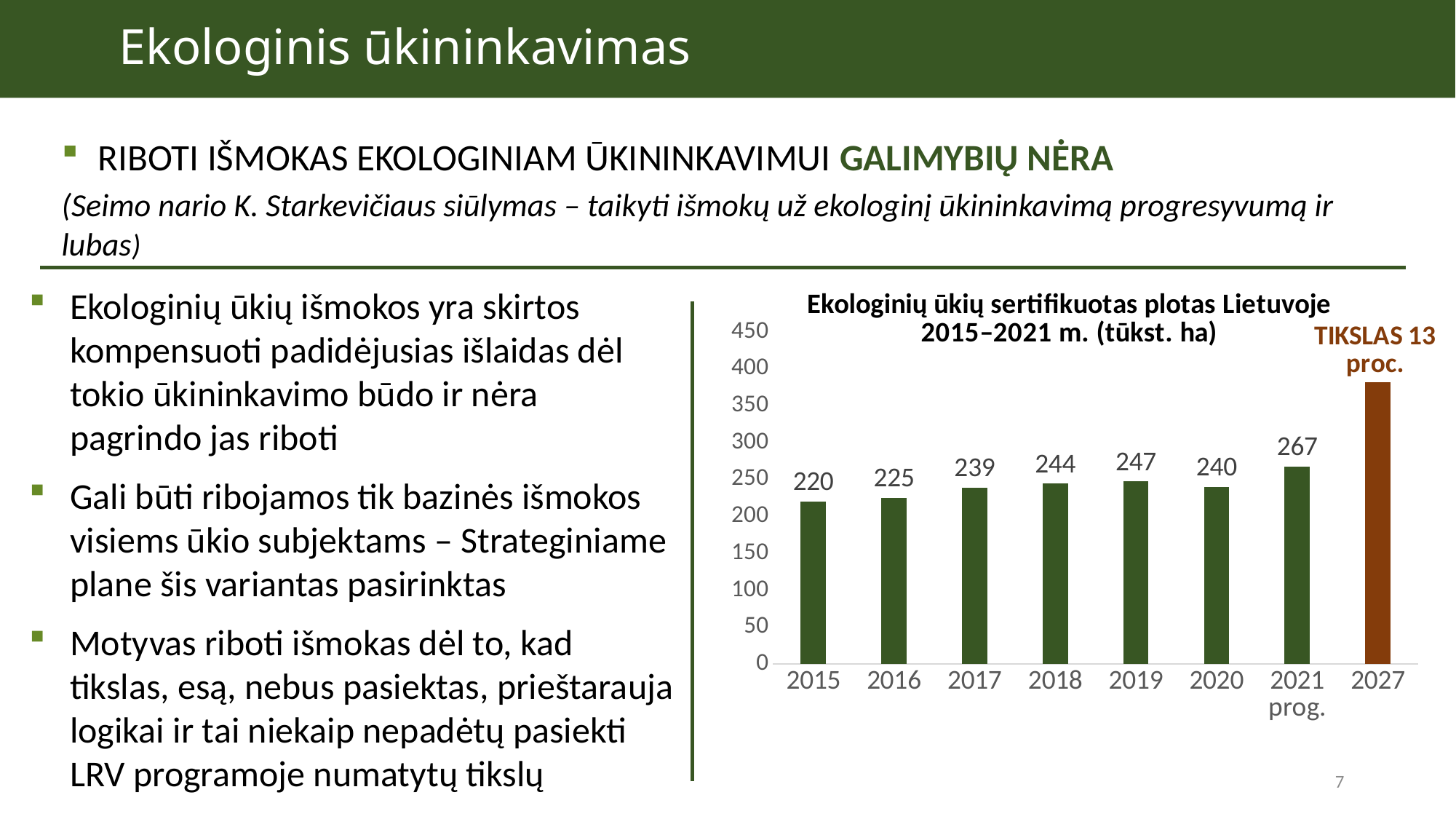
Which category has the tallest bar in the chart? 2027 How many categories are shown on the x axis of the chart? 8 Is the value for 2027 greater or less than 350? greater What is the value for 2015 in the chart? 220 What is the value for 2021 prog. in the chart? 267 Which year has the lowest value in the chart? 2015 Which is larger, the value for 2019 or the value for 2020? 2019 What is the difference between the values for 2021 prog. and 2015? 47 What is the value for 2019 in the chart? 247 Do the values rise or fall from 2015 to 2019? rise What kind of chart is shown on the slide? bar chart What is the value for 2017 in the chart? 239